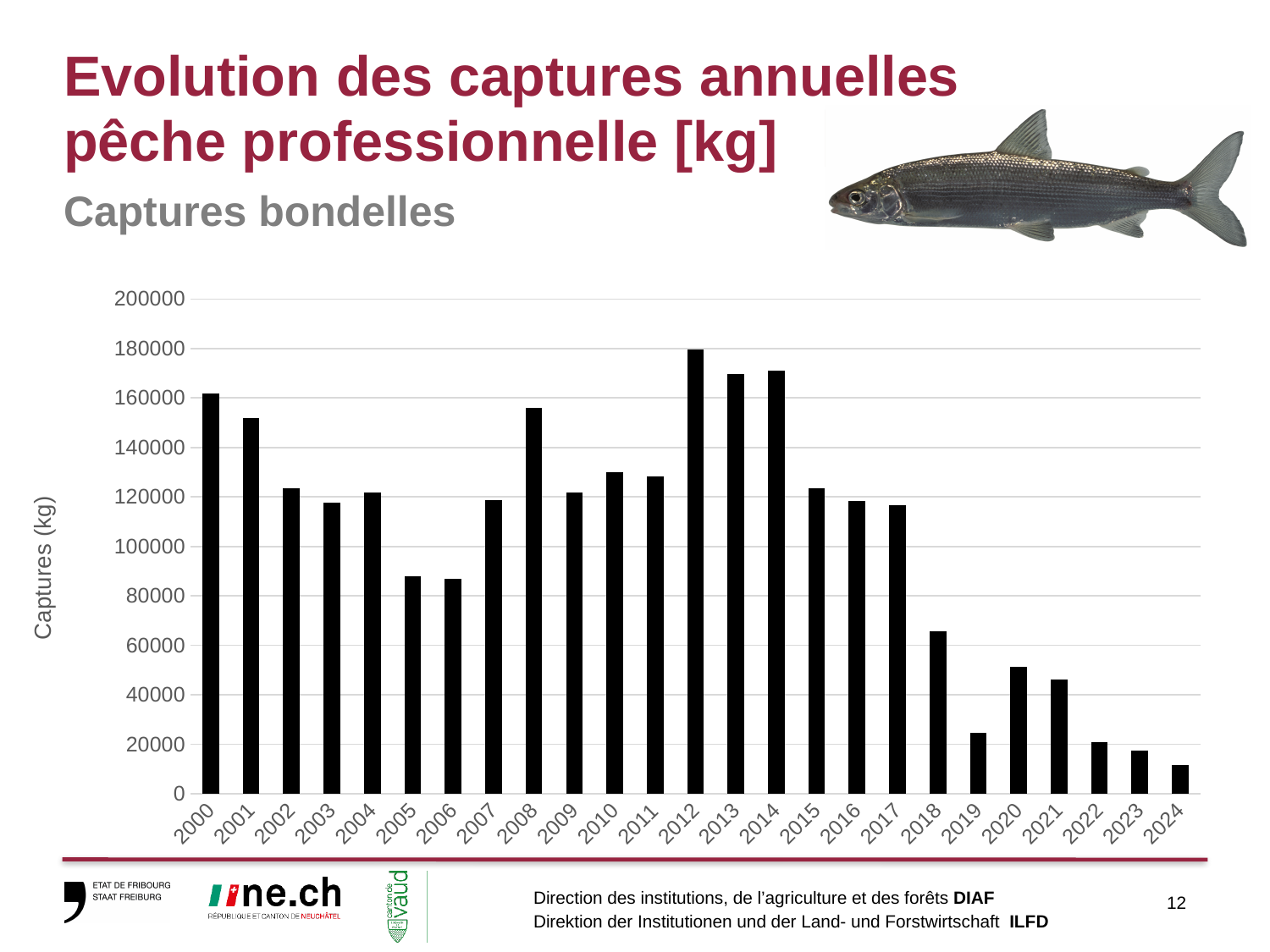
What is the label of the vertical axis of the chart? Captures (kg) Is the value for 2012 greater or less than 160000? greater Which year has the highest catch in the chart? 2012 Is the value for 2024 greater or less than 20000? less Which year has the larger catch, 2000 or 2001? 2000 How many years (bars) are plotted in the chart? 25 Which year has the larger catch, 2018 or 2019? 2018 Which year has the lowest catch in the chart? 2024 What kind of chart is shown on the slide? bar chart Do the catches rise or fall from 2017 to 2024? fall Is the value for 2005 greater or less than 100000? less